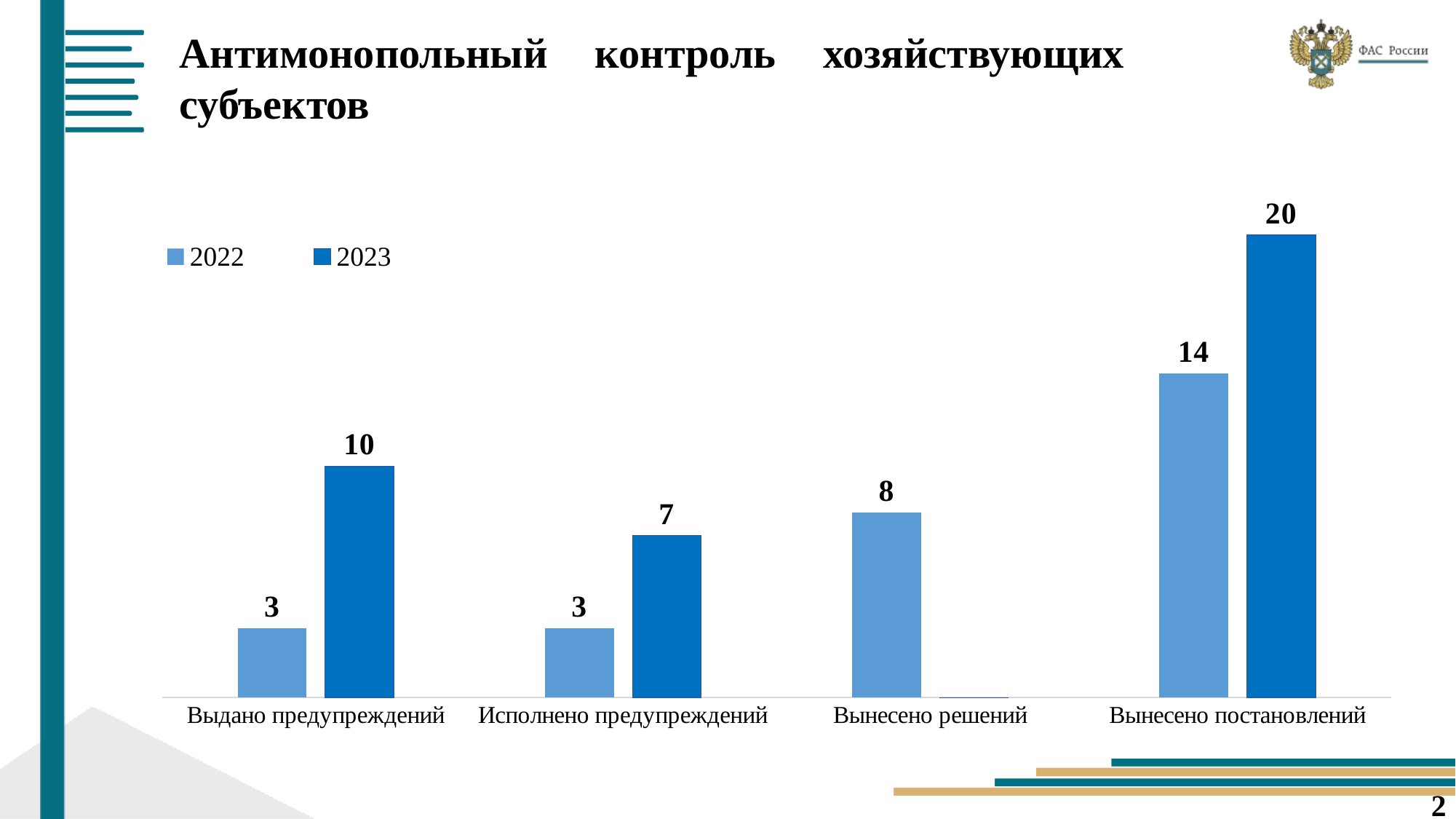
What is the 2023 value for Выдано предупреждений? 10 What is the 2022 value for Исполнено предупреждений? 3 Which category has the lowest 2022 value? Выдано предупреждений and Исполнено предупреждений (both 3) What is the 2023 value for Вынесено постановлений? 20 What type of chart is shown on the slide? bar chart How many categories are shown on the x axis? 4 What is the difference between the 2023 and 2022 values for Вынесено постановлений? 6 Which is larger for Исполнено предупреждений: the 2022 value or the 2023 value? 2023 Which category has the highest 2023 value? Вынесено постановлений How many series does the legend list? 2 What are the two series named in the legend? 2022 and 2023 What is the 2022 value for Вынесено решений? 8